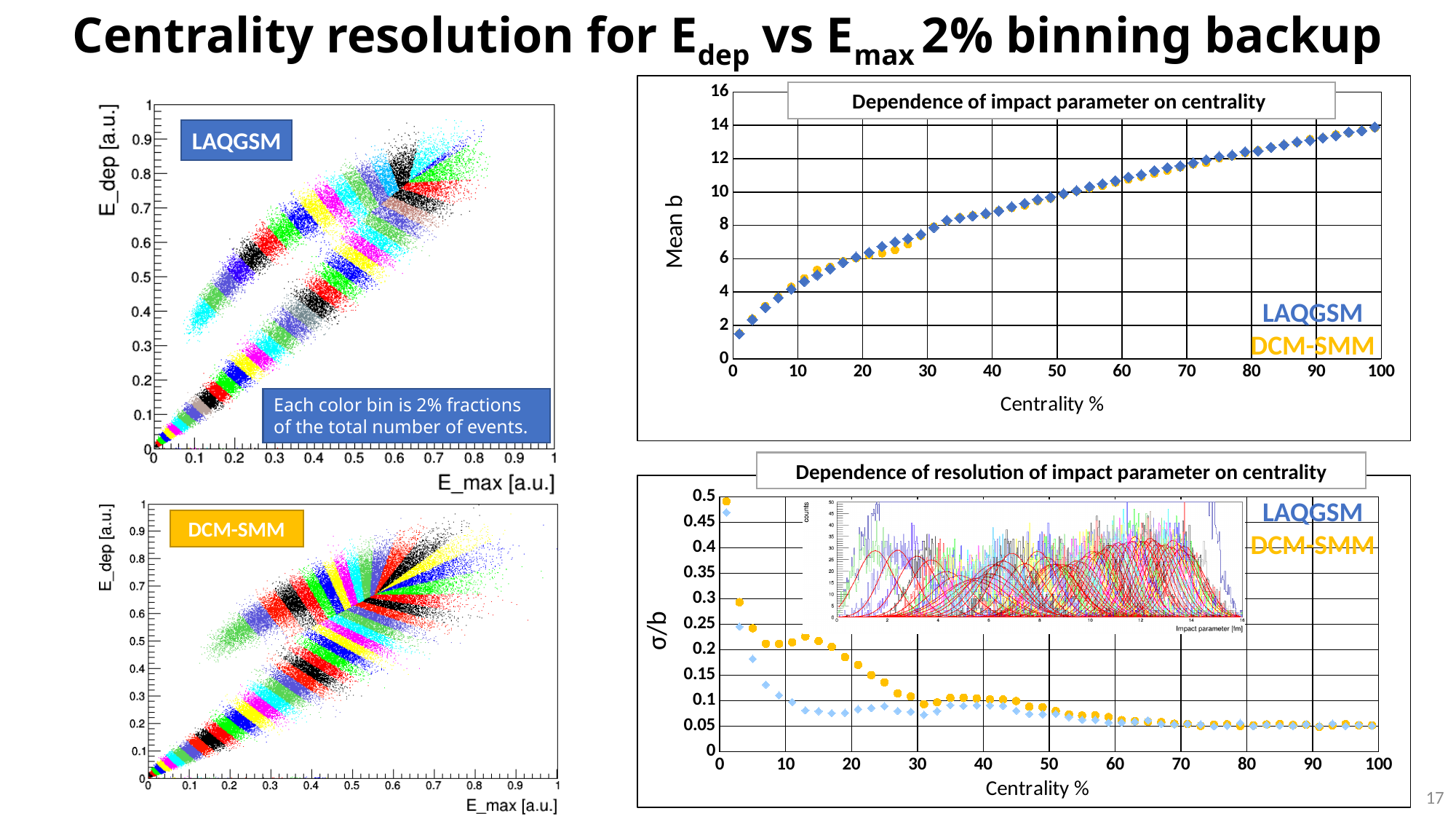
In the 'Dependence of resolution of impact parameter on centrality' chart, does σ/b rise or fall as centrality increases? fall What is the x-axis label of the DCM-SMM scatter plot on the left of the slide? E_max [a.u.] In the 'Dependence of impact parameter on centrality' chart, is Mean b at 10% centrality greater or less than 6? less What kind of chart is the 'Dependence of impact parameter on centrality' chart? scatter plot In the 'Dependence of resolution of impact parameter on centrality' chart, which series has the higher σ/b at 20% centrality, LAQGSM or DCM-SMM? DCM-SMM How many series does the legend of the 'Dependence of impact parameter on centrality' chart list? 2 What is the y-axis label of the 'Dependence of resolution of impact parameter on centrality' chart? σ/b In the 'Dependence of resolution of impact parameter on centrality' chart, is σ/b at 90% centrality greater or less than 0.1? less In the 'Dependence of resolution of impact parameter on centrality' chart, is the DCM-SMM σ/b value at the lowest centrality greater or less than 0.4? greater What kind of chart is the LAQGSM chart on the left of the slide? scatter plot In the 'Dependence of impact parameter on centrality' chart, does Mean b rise or fall as centrality increases? rise